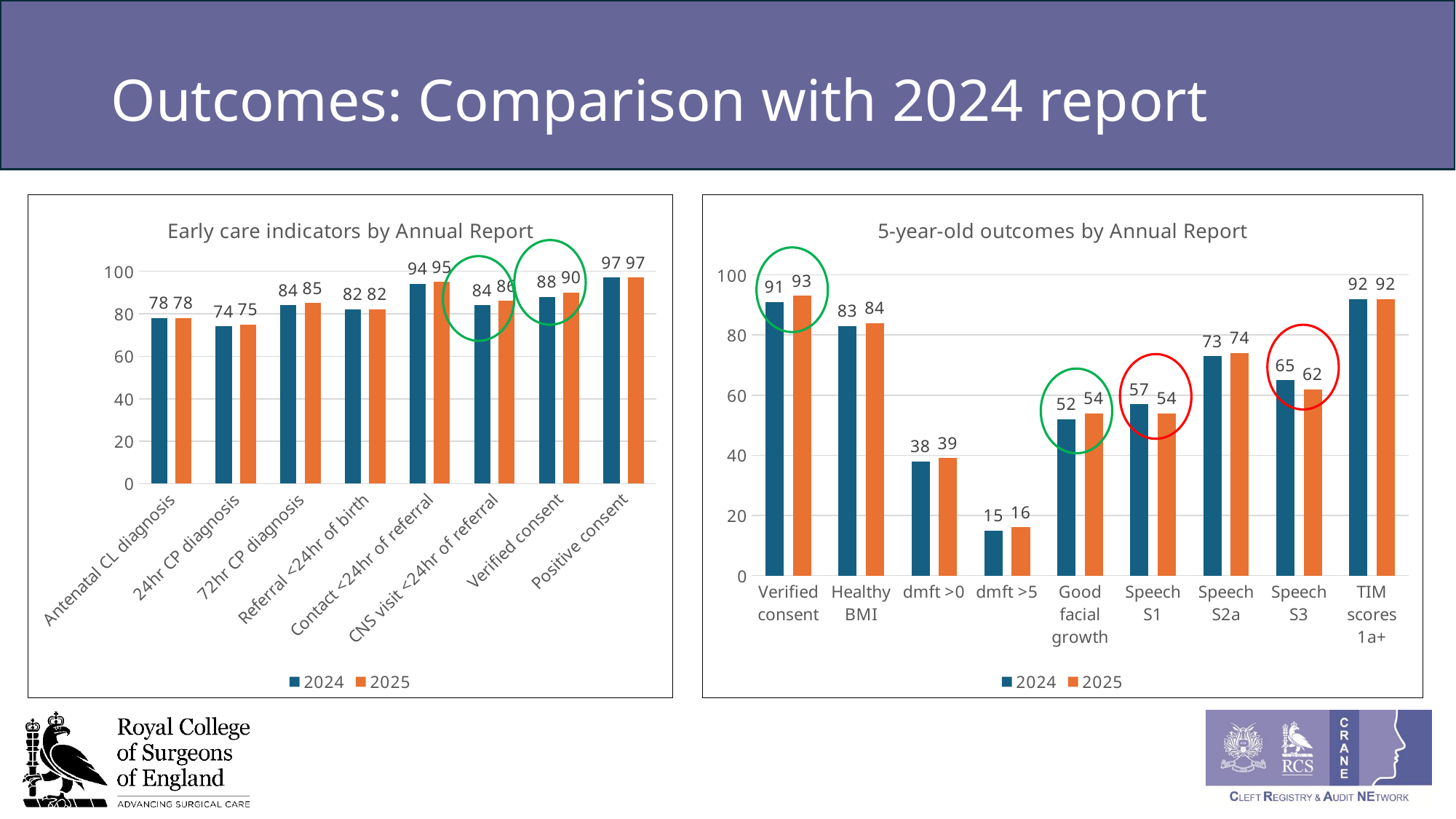
In the '5-year-old outcomes by Annual Report' chart, which category has the lowest 2024 value? dmft >5 In the '5-year-old outcomes by Annual Report' chart, which is larger for Speech S1: the 2024 value or the 2025 value? 2024 In the 'Early care indicators by Annual Report' chart, how many categories are shown on the x axis? 8 In the '5-year-old outcomes by Annual Report' chart, what is the 2025 value for Speech S3? 62 In the 'Early care indicators by Annual Report' chart, what is the difference between the 2025 and 2024 values for CNS visit <24hr of referral? 2 In the 'Early care indicators by Annual Report' chart, which category has the highest 2025 value? Positive consent In the 'Early care indicators by Annual Report' chart, which category has the lowest 2024 value? 24hr CP diagnosis In the '5-year-old outcomes by Annual Report' chart, what is the difference between the 2024 and 2025 values for Speech S3? 3 What type of chart is the '5-year-old outcomes by Annual Report' chart? Bar chart In the 'Early care indicators by Annual Report' chart, what is the 2025 value for Verified consent? 90 How many series does the legend of the '5-year-old outcomes by Annual Report' chart list? 2 In the 'Early care indicators by Annual Report' chart, what is the 2024 value for 24hr CP diagnosis? 74